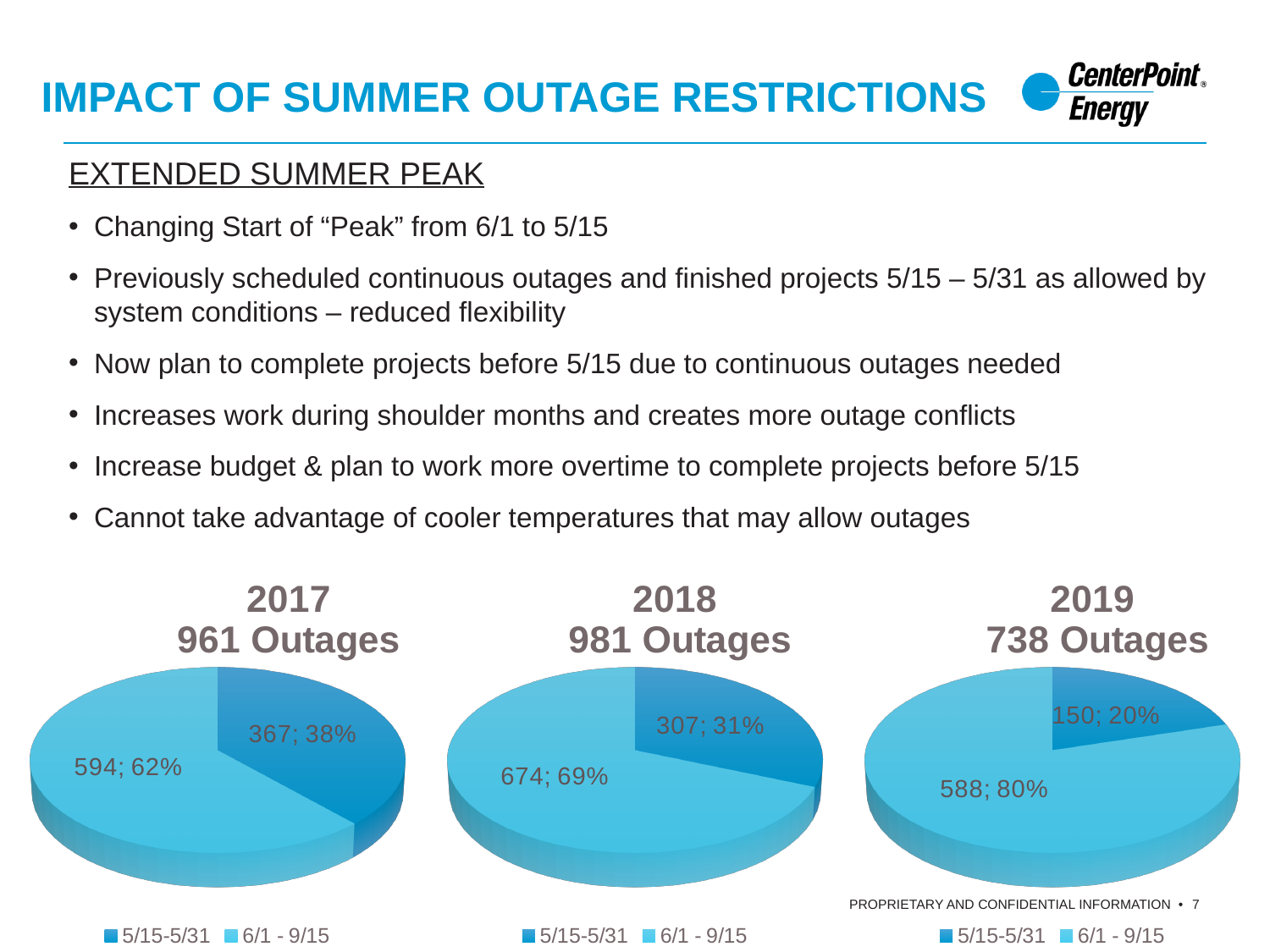
In the 2017 pie chart, how many outages occurred in the 5/15-5/31 period? 367 How many entries does the legend under the 2017 pie chart list? 2 In the 2018 pie chart, what share of outages falls in the 6/1 - 9/15 period? 69% In the 2019 pie chart, is the number of outages for 6/1 - 9/15 greater or less than 500? greater How many slices does each pie chart on the slide have? 2 In the 2018 pie chart, what is the difference in outages between the 6/1 - 9/15 and 5/15-5/31 periods? 367 In the 2017 pie chart, which period has the larger slice, 5/15-5/31 or 6/1 - 9/15? 6/1 - 9/15 What is the total number of outages shown in the title of the 2018 pie chart? 981 Outages In the 2019 pie chart, how many outages occurred in the 6/1 - 9/15 period? 588 Which year's pie chart has the smallest 5/15-5/31 slice? 2019 In the 2019 pie chart, what percentage of outages is in the 5/15-5/31 slice? 20% What type of chart is used to show the 2017, 2018 and 2019 outages? Pie chart